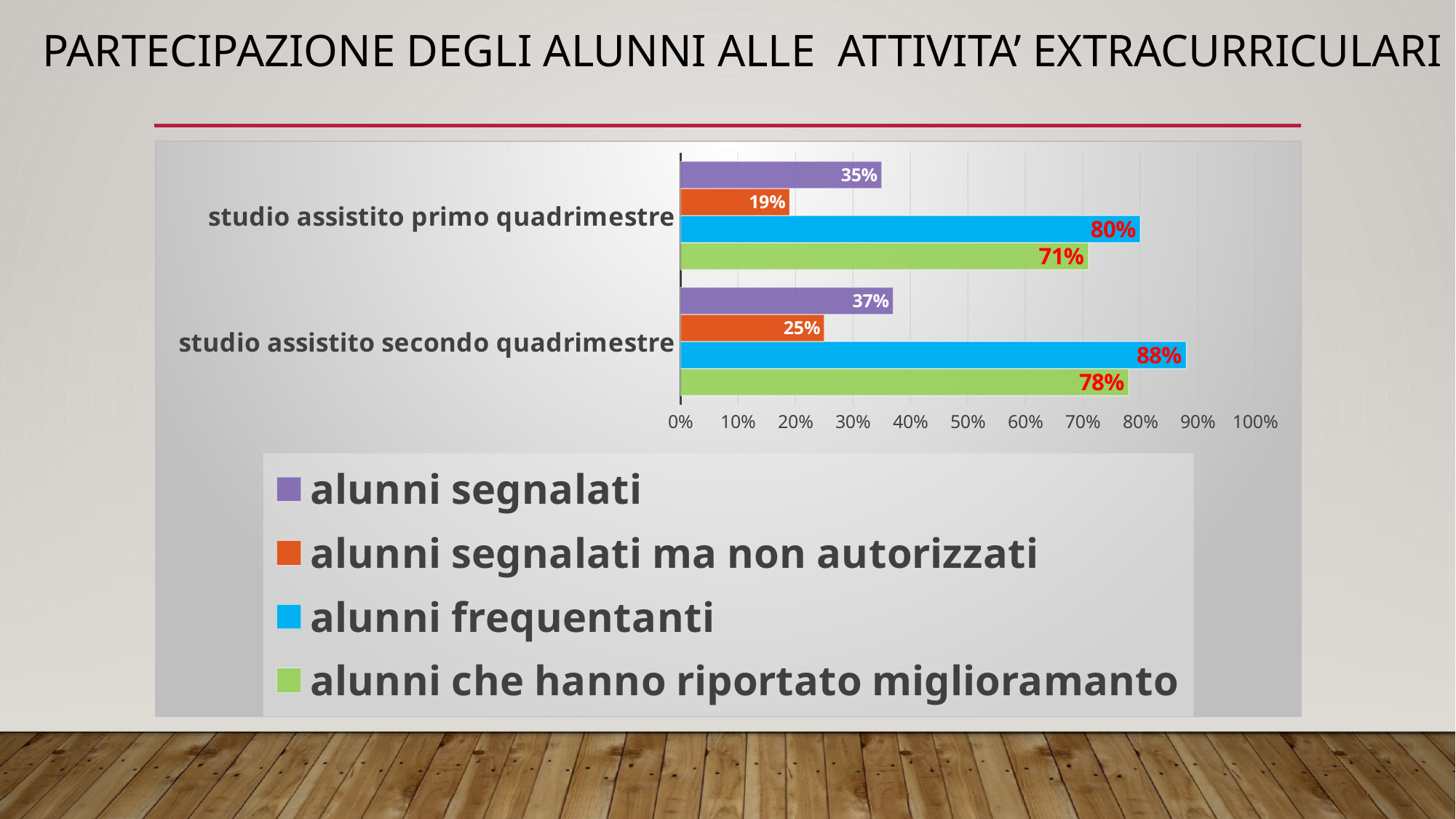
How many categories are shown on the chart? 2 What kind of chart is shown on the slide? bar chart What is the value for 'alunni frequentanti' in 'studio assistito primo quadrimestre'? 80% How many series does the legend list? 4 Which is larger: 'alunni che hanno riportato miglioramanto' in the primo quadrimestre or in the secondo quadrimestre? secondo quadrimestre What colour represents 'alunni frequentanti' in the chart? blue What is the value for 'alunni segnalati ma non autorizzati' in 'studio assistito secondo quadrimestre'? 25% Which series has the highest value in 'studio assistito secondo quadrimestre'? alunni frequentanti What is the value for 'alunni che hanno riportato miglioramanto' in 'studio assistito primo quadrimestre'? 71% What is the difference between 'alunni frequentanti' in the secondo quadrimestre and in the primo quadrimestre? 8% Which series has the lowest value in 'studio assistito primo quadrimestre'? alunni segnalati ma non autorizzati What is the value for 'alunni segnalati' in 'studio assistito secondo quadrimestre'? 37%